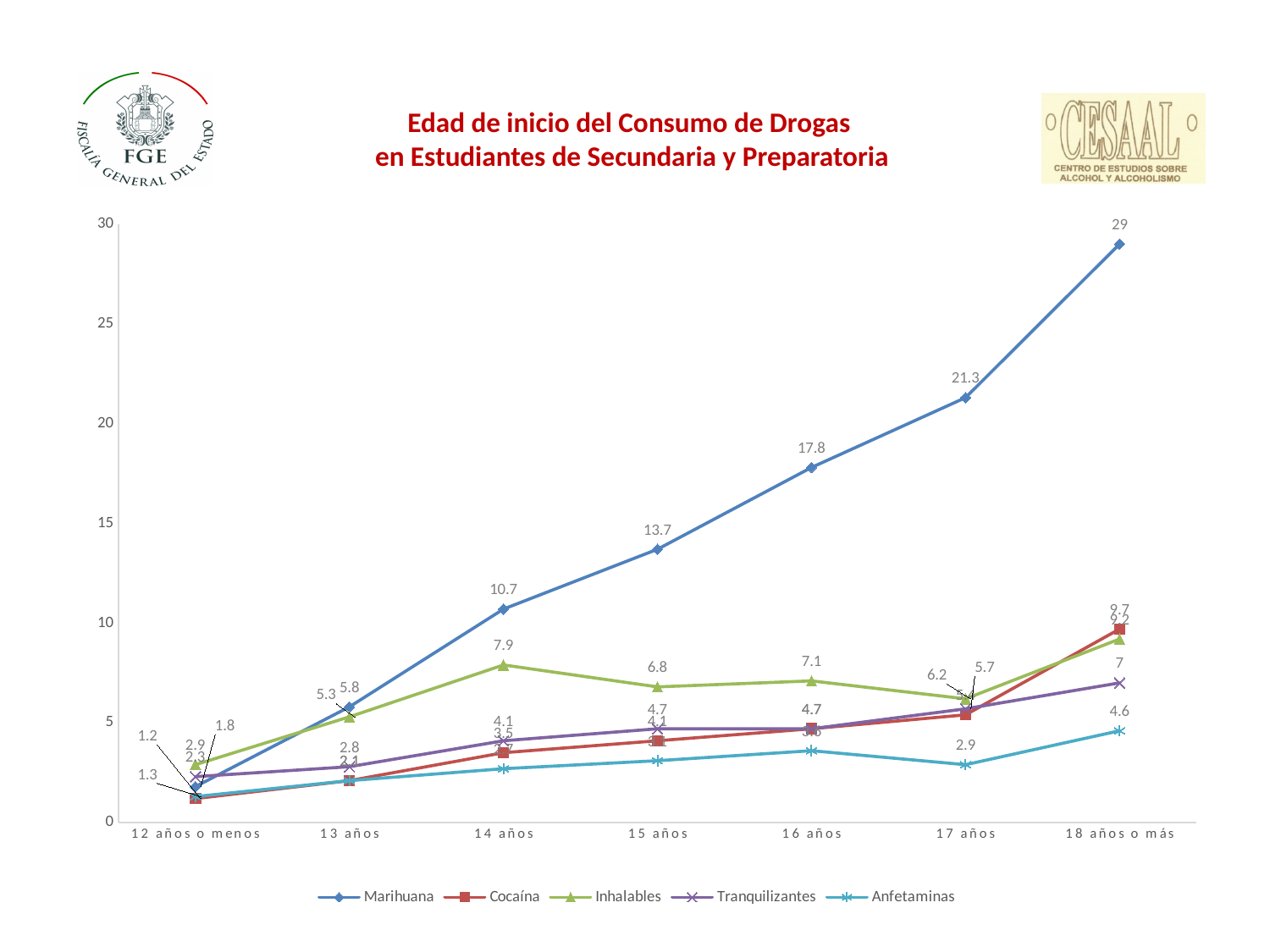
What is the value for Marihuana at '14 años'? 10.7 How many age categories are shown on the x axis? 7 What is the value for Inhalables at '14 años'? 7.9 At '15 años', which is larger: Marihuana or Inhalables? Marihuana At which age category does Marihuana reach its highest value? 18 años o más Is the value for Anfetaminas at '15 años' greater or less than 5? less Does the Marihuana line rise or fall from '12 años o menos' to '18 años o más'? rises What is the value for Marihuana at '18 años o más'? 29 How many series does the legend list? 5 What is the difference between the Marihuana values at '17 años' and '16 años'? 3.5 What kind of chart is shown on the slide? line chart What is the value for Anfetaminas at '18 años o más'? 4.6